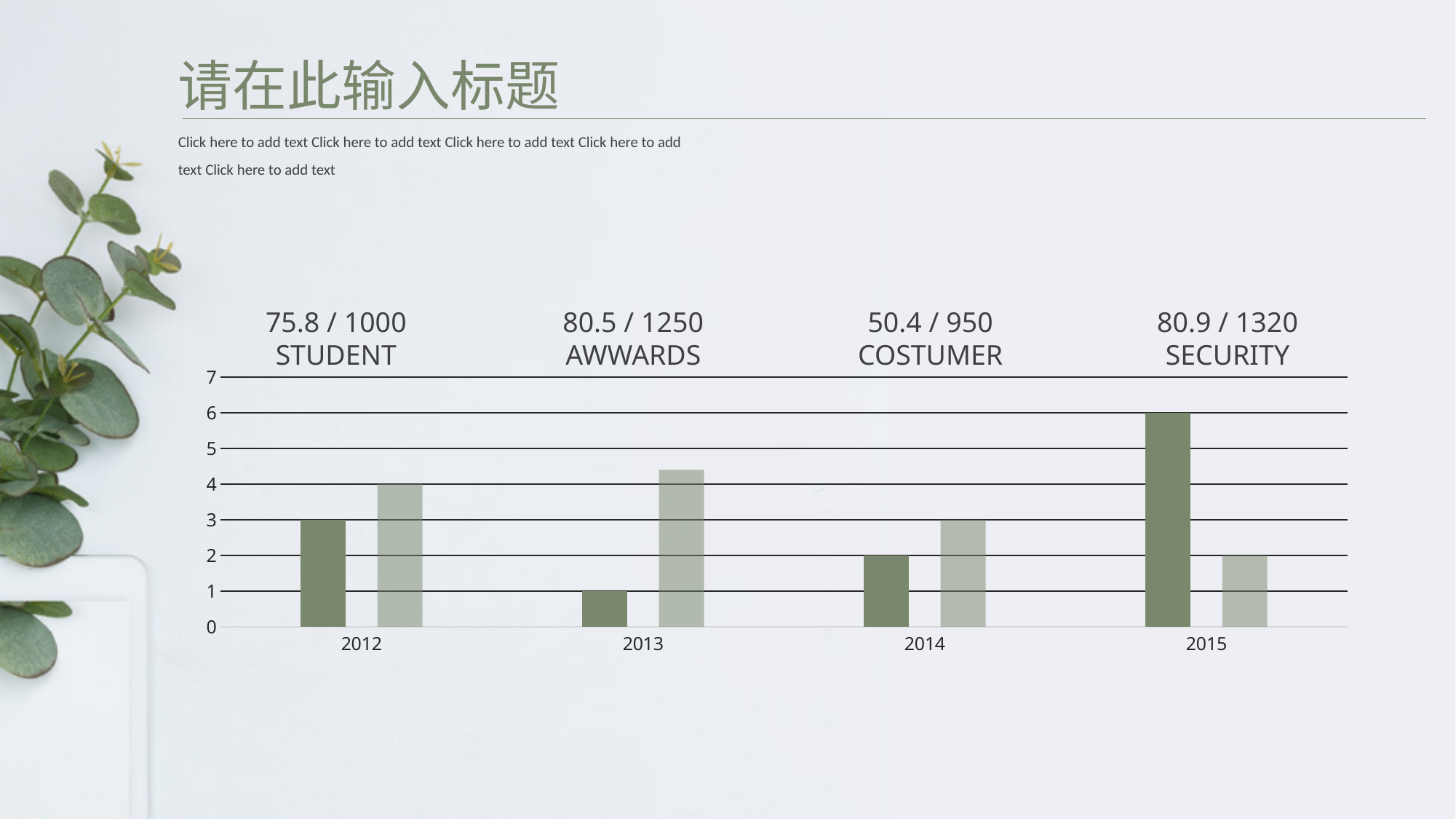
In which year is the darker green bar the highest? 2015 What label text appears above the 2013 bars? 80.5 / 1250 AWWARDS What kind of chart is shown on the slide? bar chart In which year is the darker green bar the lowest? 2013 What is the value of the lighter green bar for 2012? 4 How many years are shown on the x axis of the chart? 4 What is the value of the darker green bar for 2012? 3 Is the value of the lighter green bar for 2013 greater or less than 4? greater What is the value of the darker green bar for 2015? 6 For 2014, which bar is larger, the darker green bar or the lighter green bar? the lighter green bar What is the value of the lighter green bar for 2014? 3 What is the difference between the darker green bar and the lighter green bar for 2015? 4